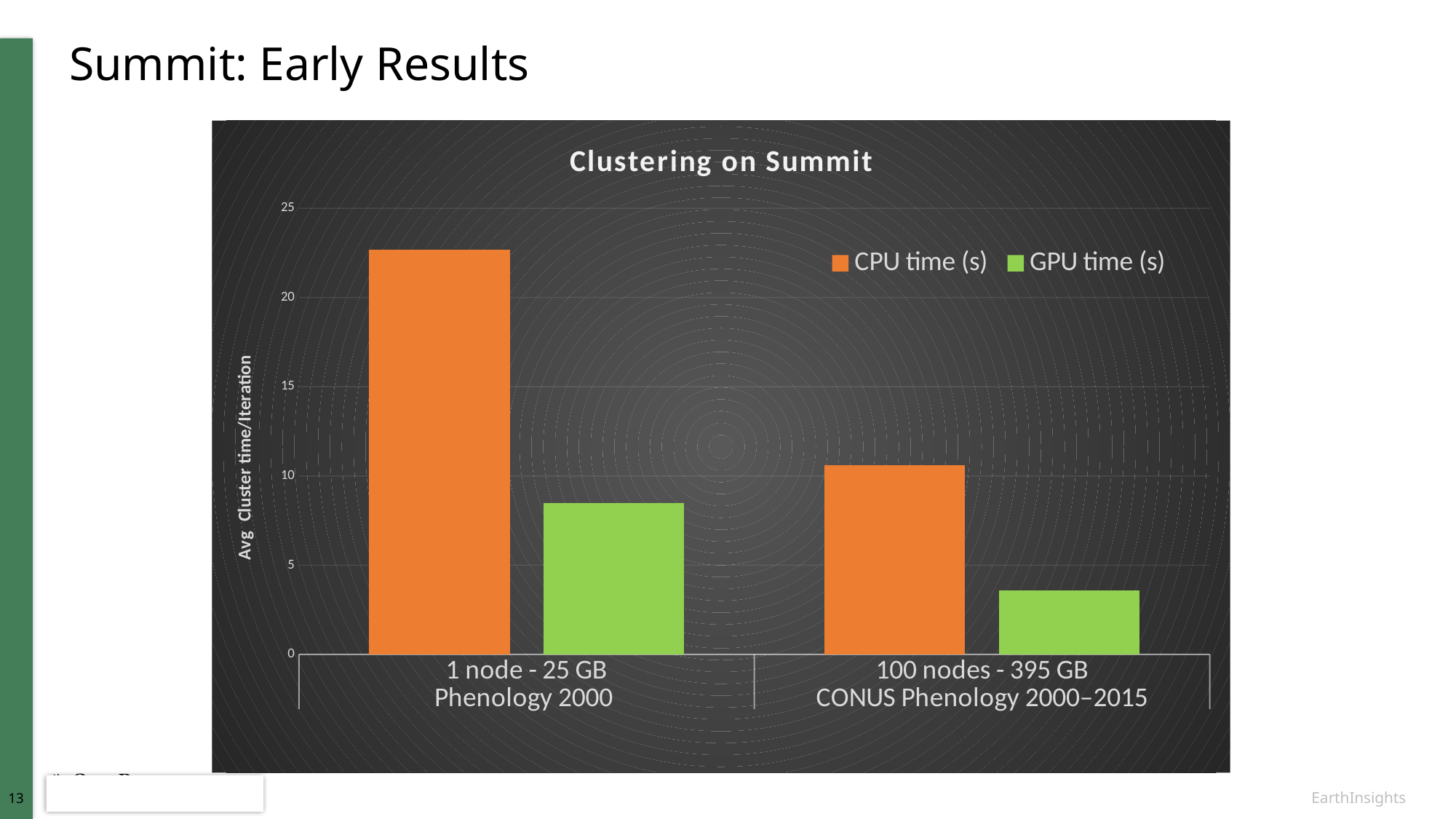
Is the GPU time for 100 nodes - 395 GB CONUS Phenology 2000–2015 greater or less than 5? less Which bar is the shortest in the chart? GPU time (s) for 100 nodes - 395 GB CONUS Phenology 2000–2015 Is the CPU time for 1 node - 25 GB Phenology 2000 greater or less than 20? greater Does the CPU time rise or fall from the 1 node category to the 100 nodes category? fall How many categories are shown on the x axis? 2 For 1 node - 25 GB Phenology 2000, which is larger: CPU time or GPU time? CPU time (s) Is the CPU time for 100 nodes - 395 GB CONUS Phenology 2000–2015 greater or less than 15? less Which bar is the tallest in the chart? CPU time (s) for 1 node - 25 GB Phenology 2000 What type of chart is shown on the slide? bar chart What is the title of the chart? Clustering on Summit How many series does the legend list? 2